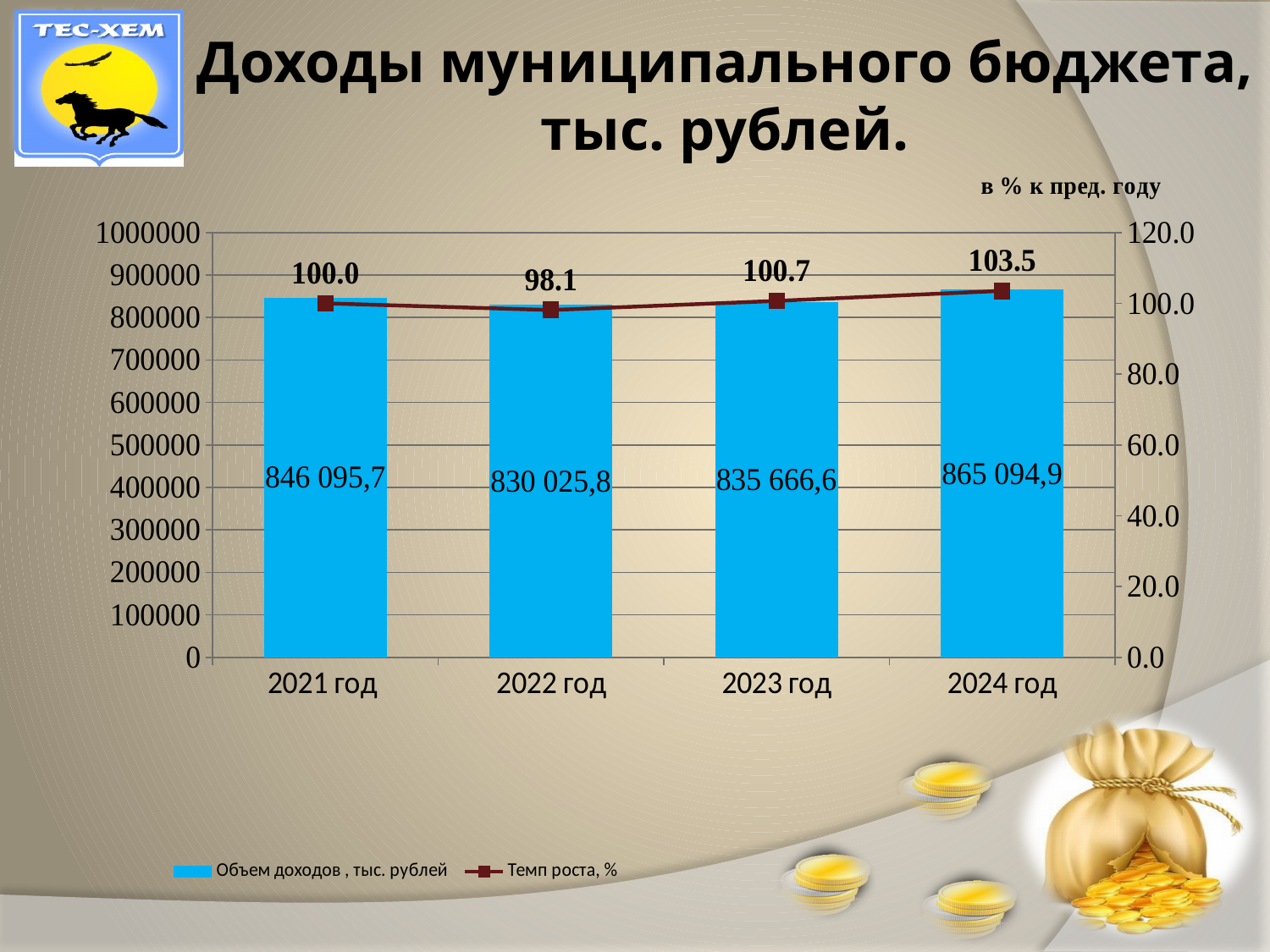
What is the Темп роста, % value for 2022 год? 98.1 Does the Темп роста, % line rise or fall from 2022 год to 2024 год? rise Which year has the lowest Темп роста, %? 2022 год Is the Объем доходов for 2022 год greater or less than 800000? greater What is the value of Объем доходов for 2024 год? 865 094,9 What is the difference in Объем доходов between 2024 год and 2022 год? 35 069,1 Which is larger, the Объем доходов for 2021 год or for 2023 год? 2021 год How many series does the legend list? 2 What is the value of Объем доходов for 2021 год? 846 095,7 What is the difference in Темп роста, % between 2024 год and 2022 год? 5.4 Which year has the highest Объем доходов? 2024 год How many years are shown on the x axis? 4